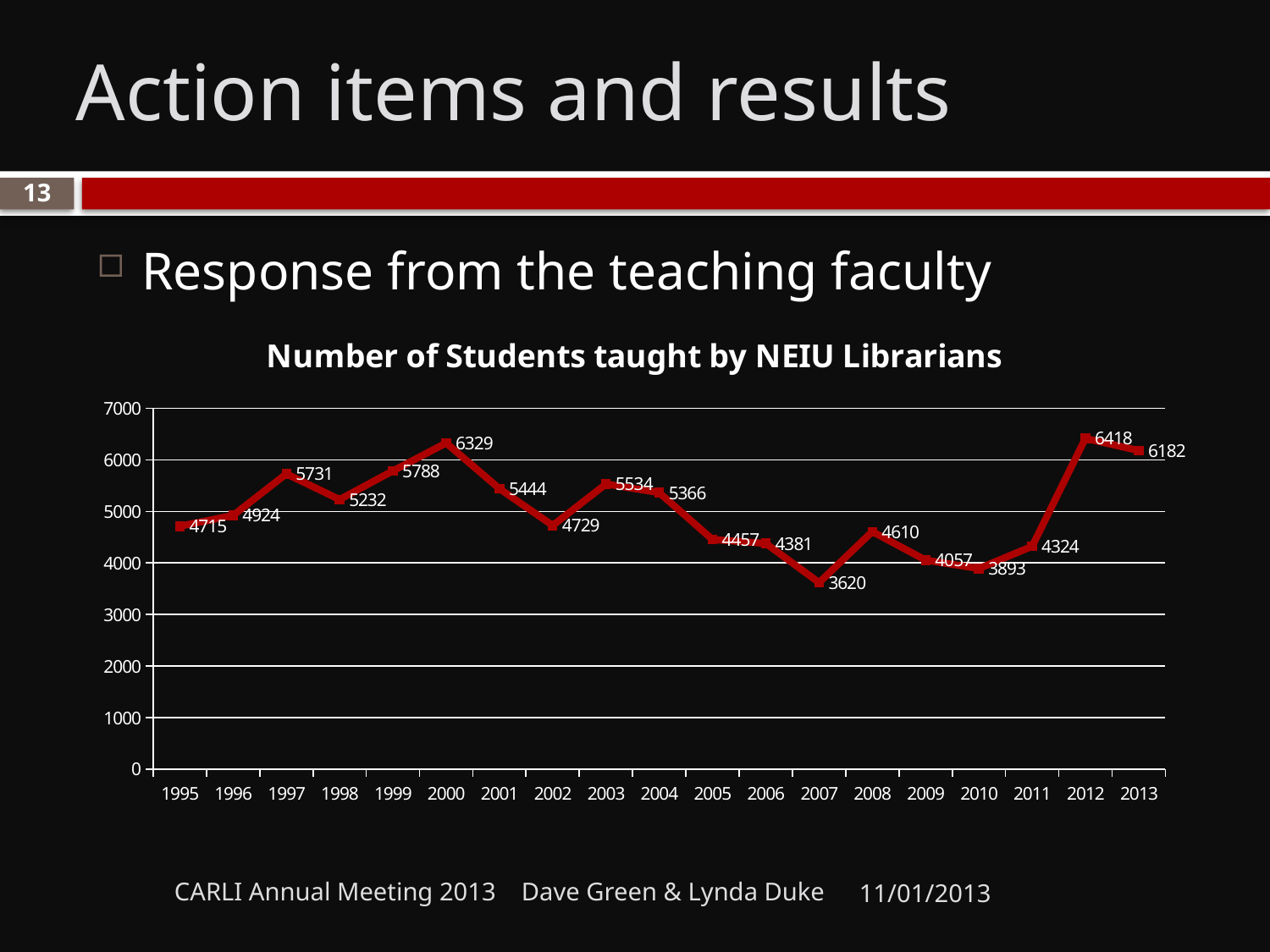
Which year has a larger value, 1997 or 1999? 1999 What is the title of the chart? Number of Students taught by NEIU Librarians Which year has the lowest number of students taught? 2007 Which year has the highest number of students taught? 2012 What is the difference between the values for 2012 and 2011? 2094 What is the number of students taught by NEIU librarians in 2000? 6329 What kind of chart is shown on the slide? line chart What is the value for 2007 in the chart? 3620 How many years are plotted on the x axis? 19 Is the value for 2010 greater or less than 4000? less Do the values rise or fall from 2004 to 2007? fall What is the value for 2013 in the chart? 6182